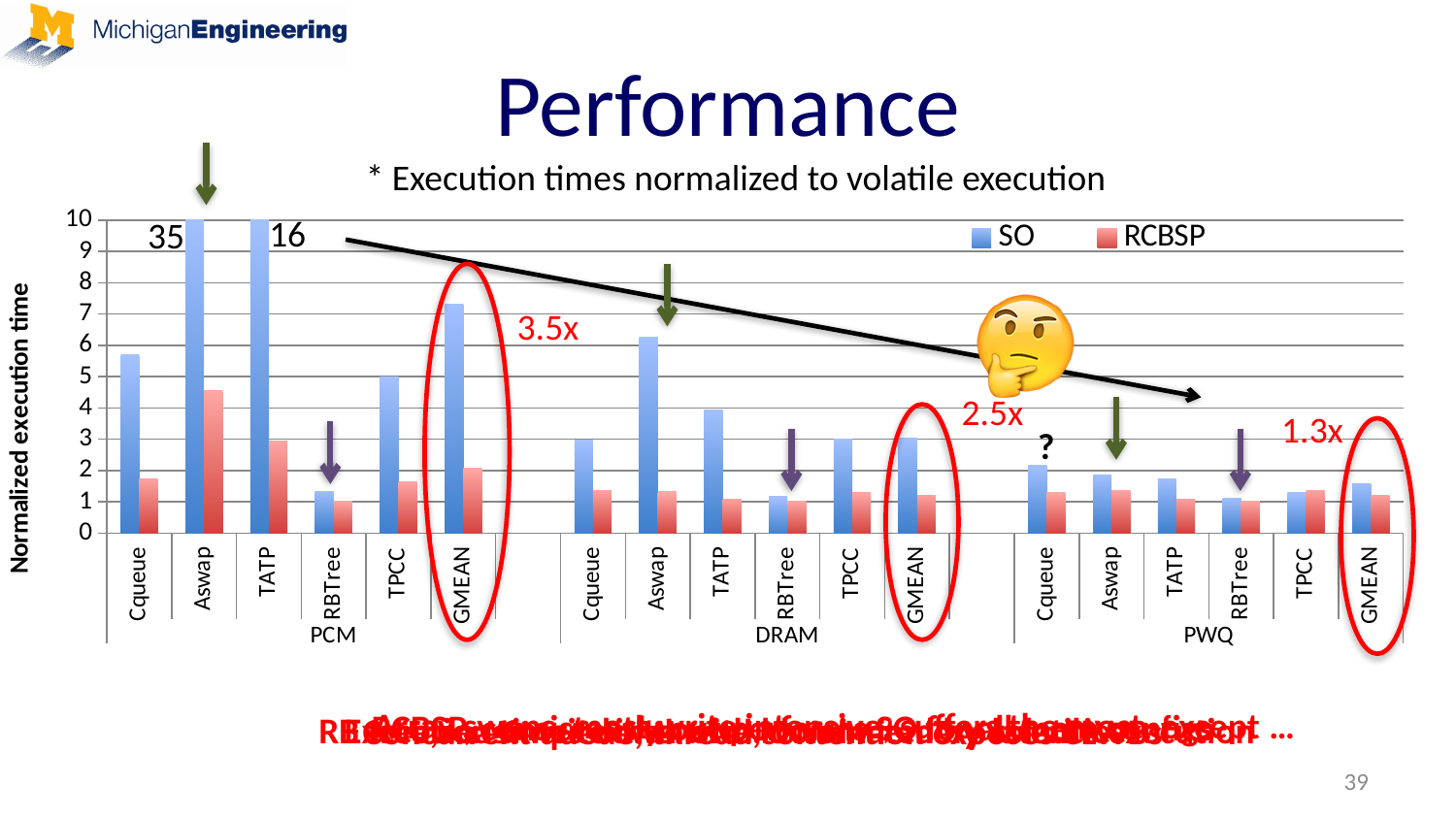
What is the difference between the SO values for Aswap and TATP in the PCM group? 19 What are the two series named in the legend? SO and RCBSP What is the SO value for Aswap in the PCM group? 35 Is the SO value for GMEAN in the PWQ group greater or less than 2? less How many series does the legend list? 2 Which benchmark in the PCM group has the lowest SO value? RBTree What is the label of the y axis? Normalized execution time What is the SO value for TATP in the PCM group? 16 What kind of chart is shown on the slide? bar chart Which benchmark in the PCM group has the highest SO value? Aswap Is the SO value for Cqueue in the PCM group greater or less than 5? greater For Cqueue in the DRAM group, which is larger, the SO value or the RCBSP value? SO